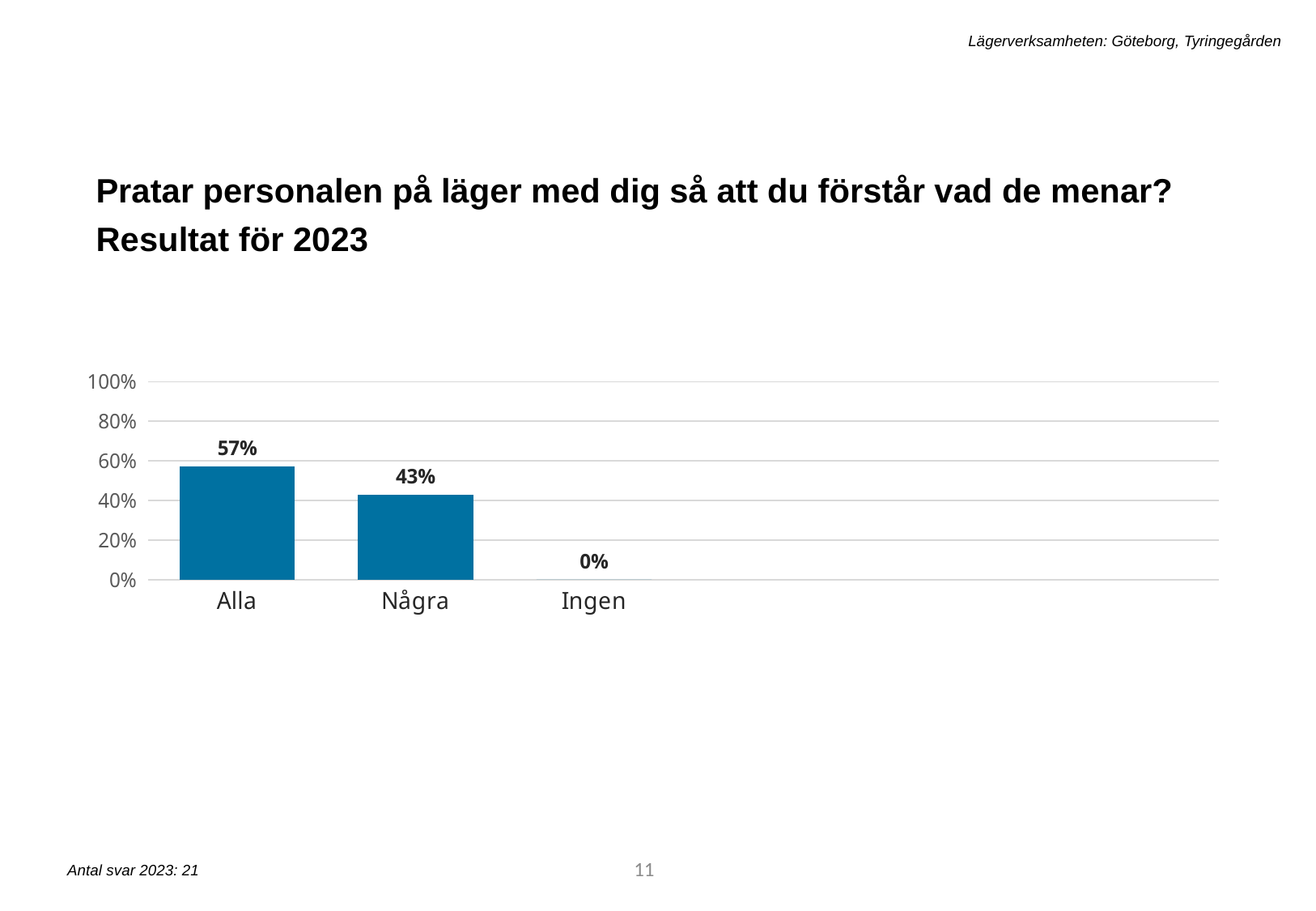
How many categories are shown on the x axis? 3 Which is larger, the value for Alla or the value for Några? Alla What is the value for Alla? 57% What is the value for Några? 43% What is the difference between the values for Alla and Några? 14% Which category has the highest value? Alla What kind of chart is shown on the slide? bar chart What is the value for Ingen? 0% Do the values rise or fall from left to right along the x axis? fall Is the value for Några greater or less than 60%? less Which category has the lowest value? Ingen Is the value for Alla greater or less than 40%? greater